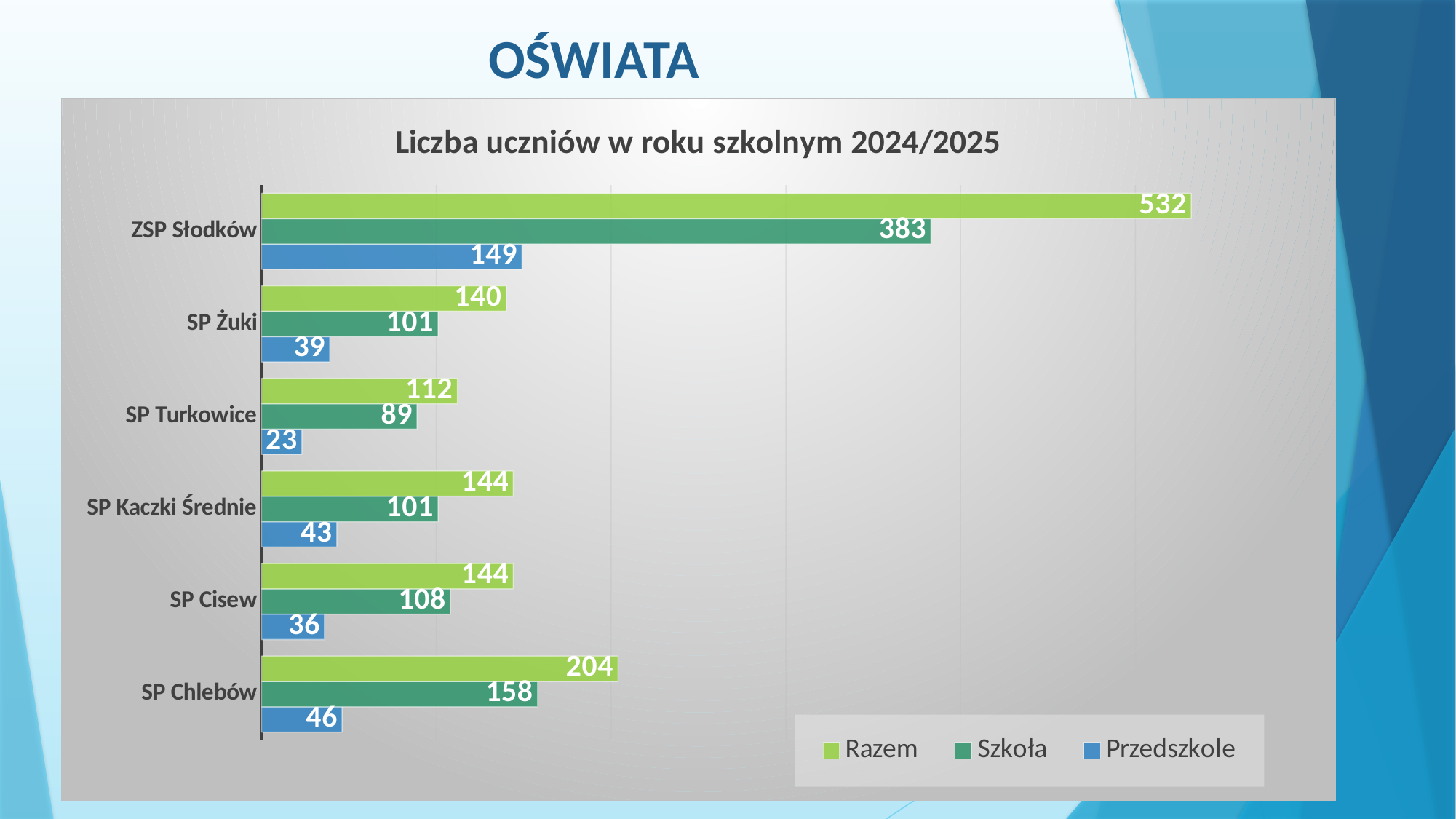
Which school has the lowest Przedszkole value? SP Turkowice What is the Razem value for ZSP Słodków? 532 Which school has the highest Razem value? ZSP Słodków How many series does the legend list? 3 Which is larger, the Przedszkole value for SP Kaczki Średnie or for SP Cisew? SP Kaczki Średnie Which series is shown in blue? Przedszkole What is the Przedszkole value for SP Turkowice? 23 What is the title of the chart? Liczba uczniów w roku szkolnym 2024/2025 How many schools are shown on the chart? 6 What is the Szkoła value for SP Chlebów? 158 What is the difference between the Szkoła values for ZSP Słodków and SP Chlebów? 225 What kind of chart is shown? bar chart